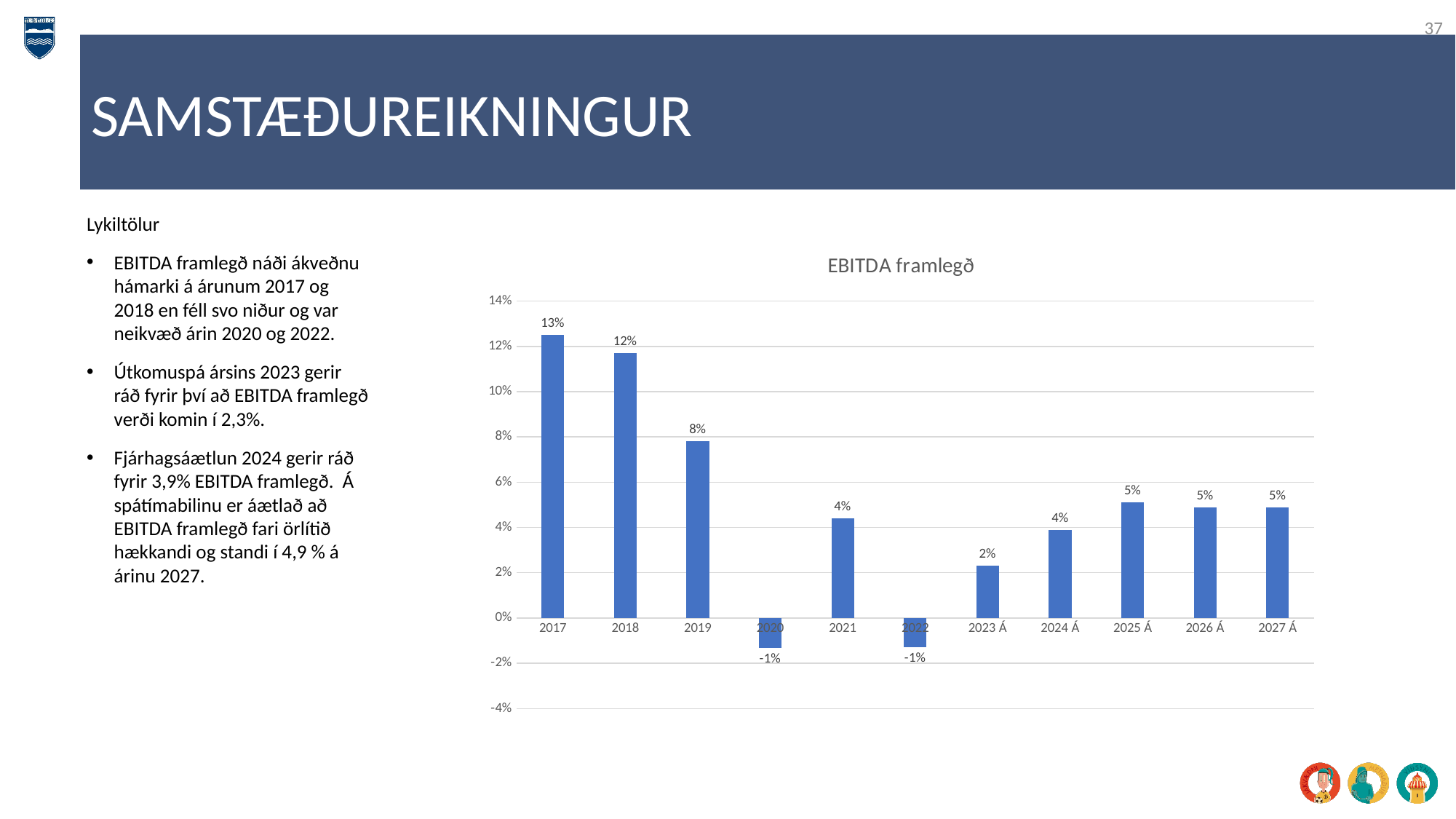
What kind of chart is used to show EBITDA framlegð? bar chart Which has a higher EBITDA framlegð, 2019 or 2021? 2019 What value is labelled for 2020 in the EBITDA framlegð chart? -1% Which year has the highest EBITDA framlegð in the chart? 2017 What is the EBITDA framlegð value shown for 2017? 13% What is the value shown for 2019 in the EBITDA framlegð chart? 8% What is the value shown for 2023 Á in the EBITDA framlegð chart? 2% What is the difference between the labelled values for 2017 and 2018 in the EBITDA framlegð chart? 1% Do the EBITDA framlegð values rise or fall from 2017 to 2020? fall What is the title of the chart on the slide? EBITDA framlegð Is the value for 2018 in the EBITDA framlegð chart greater or less than 10%? greater How many years (categories) are shown on the x axis of the EBITDA framlegð chart? 11